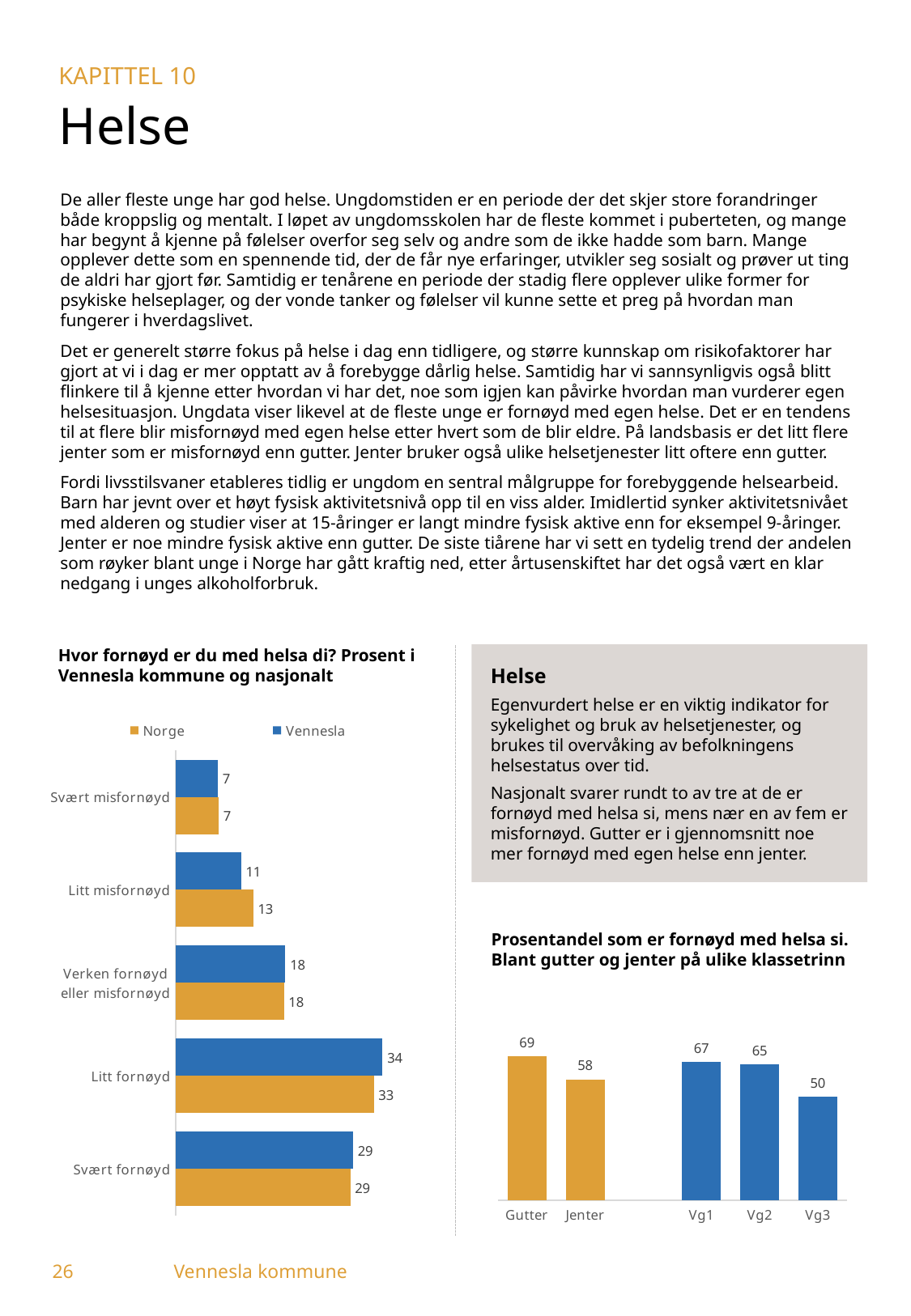
In the chart 'Hvor fornøyd er du med helsa di?', which colour represents Norge? Orange In the chart 'Hvor fornøyd er du med helsa di?', which category has the highest value for Vennesla? Litt fornøyd In the chart 'Hvor fornøyd er du med helsa di?', what is the value for Vennesla in the 'Litt fornøyd' category? 34 In the chart 'Hvor fornøyd er du med helsa di?', how many series does the legend list? 2 In the chart 'Hvor fornøyd er du med helsa di?', what is the value for Norge in the 'Litt misfornøyd' category? 13 In the chart 'Prosentandel som er fornøyd med helsa si', do the values rise or fall from Vg1 to Vg3? Fall In the chart 'Hvor fornøyd er du med helsa di?', how many categories are shown? 5 In the chart 'Hvor fornøyd er du med helsa di?', which category has the lowest value for Norge? Svært misfornøyd In the chart 'Prosentandel som er fornøyd med helsa si', which category has the lowest value? Vg3 In the chart 'Prosentandel som er fornøyd med helsa si', what is the value for Jenter? 58 In the chart 'Prosentandel som er fornøyd med helsa si', what is the difference between Gutter and Jenter? 11 In the chart 'Hvor fornøyd er du med helsa di?', what is the difference between the Norge and Vennesla values for 'Litt misfornøyd'? 2